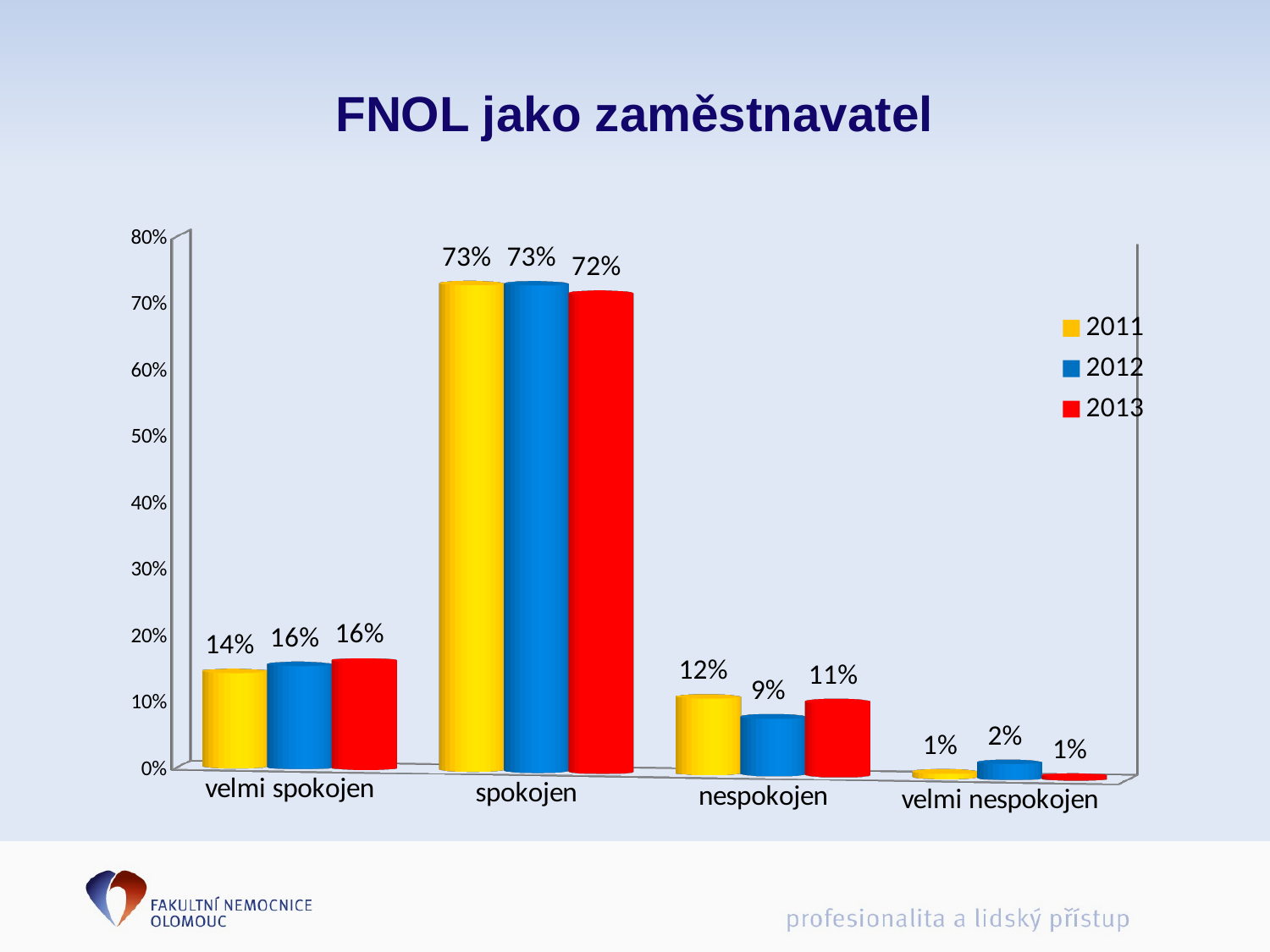
Which is larger for "velmi spokojen": the 2011 value or the 2013 value? 2013 What kind of chart is shown on the slide? bar chart What is the value for "velmi nespokojen" in 2012? 2% What is the value for "nespokojen" in 2012? 9% What is the value for "velmi spokojen" in 2011? 14% What is the value for "spokojen" in 2013? 72% Which category has the lowest value in 2013? velmi nespokojen How many categories are shown on the x axis? 4 What is the title of the chart? FNOL jako zaměstnavatel What is the difference between the 2011 and 2012 values for "nespokojen"? 3% Which category has the highest value in 2011? spokojen How many series does the legend list? 3